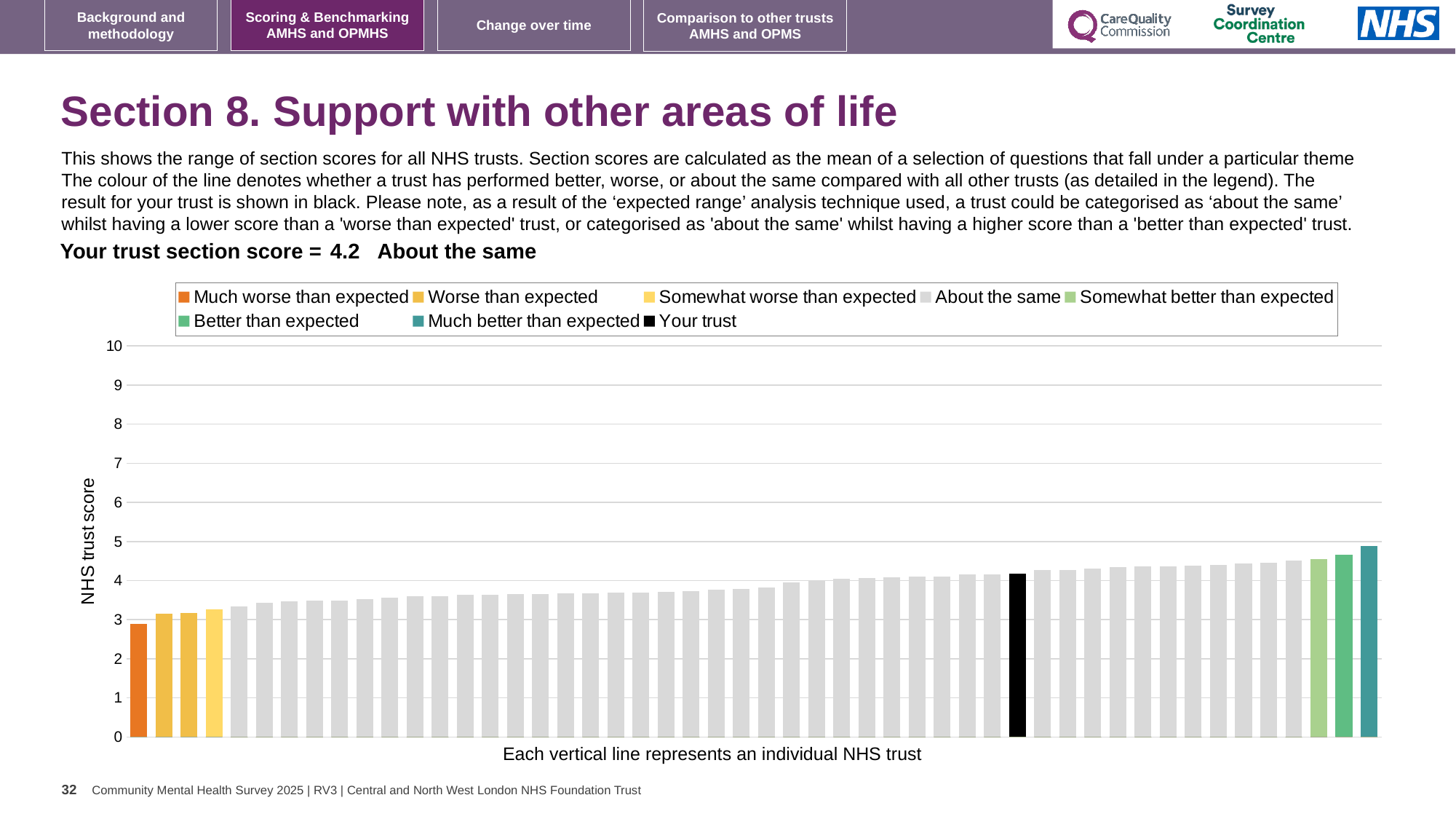
How many entries does the chart legend list? 8 Do the bar values rise or fall from left to right along the x axis? rise Is the value of the rightmost (teal) bar greater or less than 4? greater Which legend category does the highest bar belong to? Much better than expected Which legend category does the lowest bar belong to? Much worse than expected Is the value for your trust (the black bar) greater or less than 4? greater Is the value of the leftmost (orange) bar greater or less than 2? greater What is the section score for your trust shown on the slide? 4.2 What kind of chart is shown on the slide? bar chart Which category is your trust placed in for this section? About the same What is the label on the vertical axis of the chart? NHS trust score